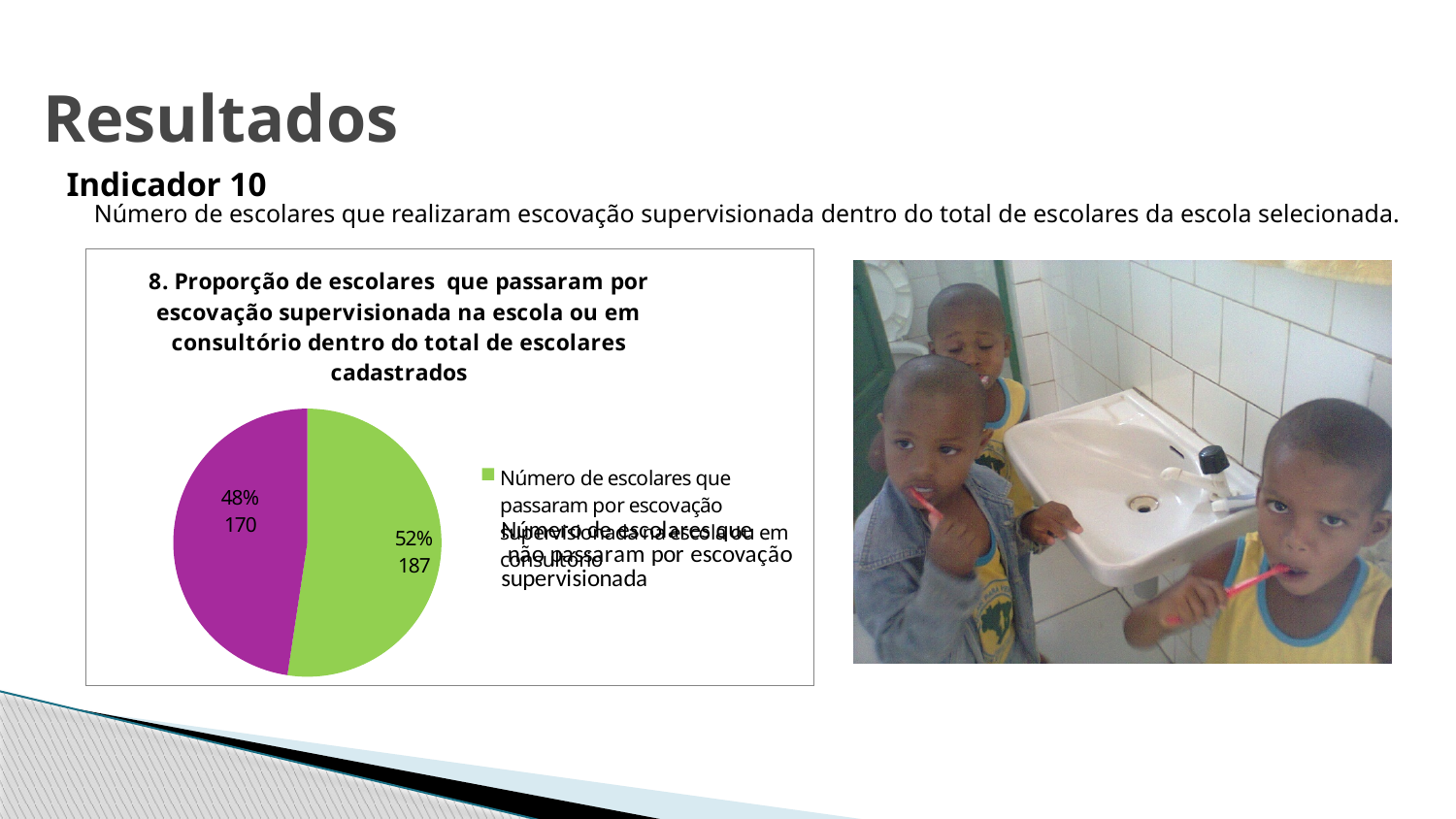
What is the difference between the number of escolares que passaram (187) and que não passaram (170) por escovação supervisionada? 17 How many slices does the pie chart have? 2 What number appears at the start of the chart title? 8 Which slice of the pie chart is larger: escolares que passaram or escolares que não passaram por escovação supervisionada? escolares que passaram por escovação supervisionada What percentage of the pie corresponds to the magenta slice (escolares que não passaram por escovação supervisionada)? 48% What colour is the slice for escolares que passaram por escovação supervisionada? green How many escolares passaram por escovação supervisionada according to the pie chart? 187 How many escolares não passaram por escovação supervisionada according to the pie chart? 170 Which category has the smallest share of the pie chart? Número de escolares que não passaram por escovação supervisionada What is the total number of escolares represented in the pie chart? 357 What percentage of the pie corresponds to the green slice (escolares que passaram por escovação supervisionada)? 52% What kind of chart is shown on the slide? pie chart